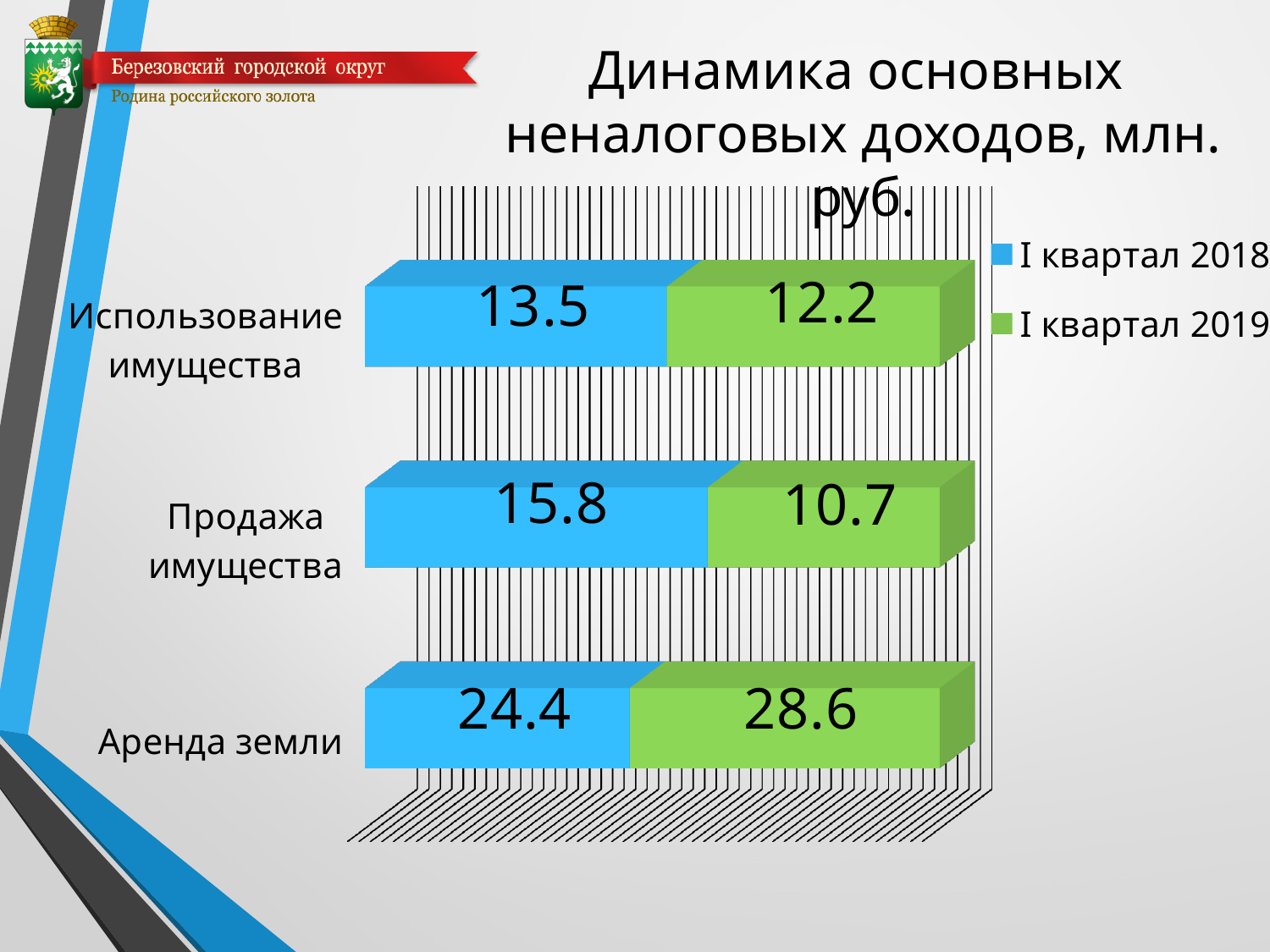
What is the value for Продажа имущества in the I квартал 2018 series? 15.8 Which category has the highest value in the I квартал 2018 series? Аренда земли What is the difference between the I квартал 2018 and I квартал 2019 values for Продажа имущества? 5.1 Which colour represents the I квартал 2019 series? Green For Аренда земли, which is larger: the I квартал 2018 value or the I квартал 2019 value? I квартал 2019 How many categories are shown on the chart? 3 Which category has the lowest value in the I квартал 2019 series? Продажа имущества What is the total of the stacked bar for Использование имущества? 25.7 How many series does the legend list? 2 What is the value for Аренда земли in the I квартал 2019 series? 28.6 What kind of chart is shown on the slide? Bar chart What is the value for Использование имущества in the I квартал 2019 series? 12.2